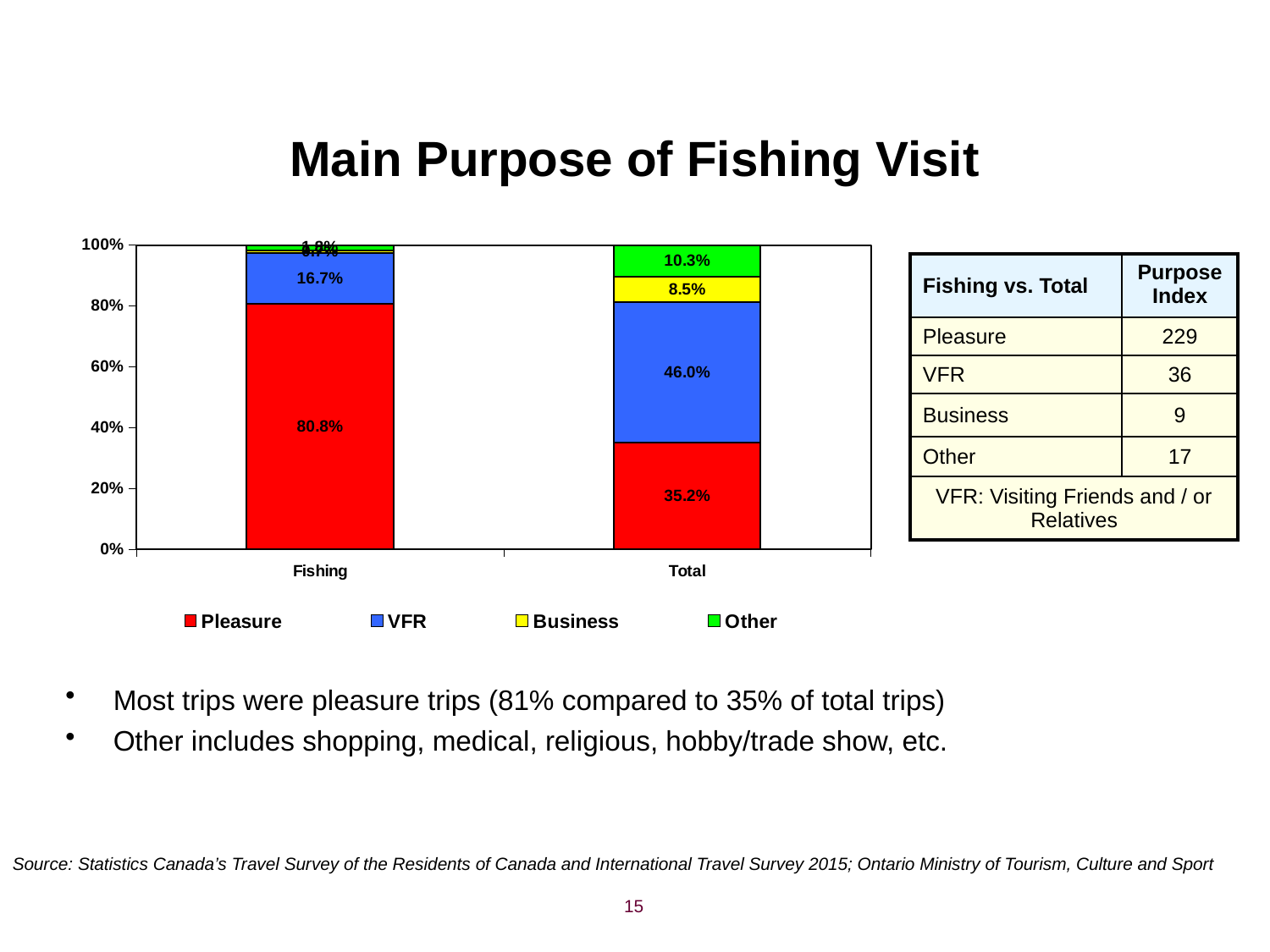
What is the value for Pleasure in the Fishing bar? 80.8% What kind of chart is shown on the slide? Stacked bar chart How many bars (categories) are shown on the x axis? 2 What is the value for VFR in the Total bar? 46.0% What is the value for VFR in the Fishing bar? 16.7% What is the value for Business in the Total bar? 8.5% Which segment is the largest in the Total bar? VFR What is the difference between the Pleasure share for Fishing and the Pleasure share for Total? 45.6 percentage points Is the VFR value for Total greater or less than 40%? greater Which has the larger VFR share, Fishing or Total? Total What is the value for Other in the Total bar? 10.3% How many series does the legend list? 4